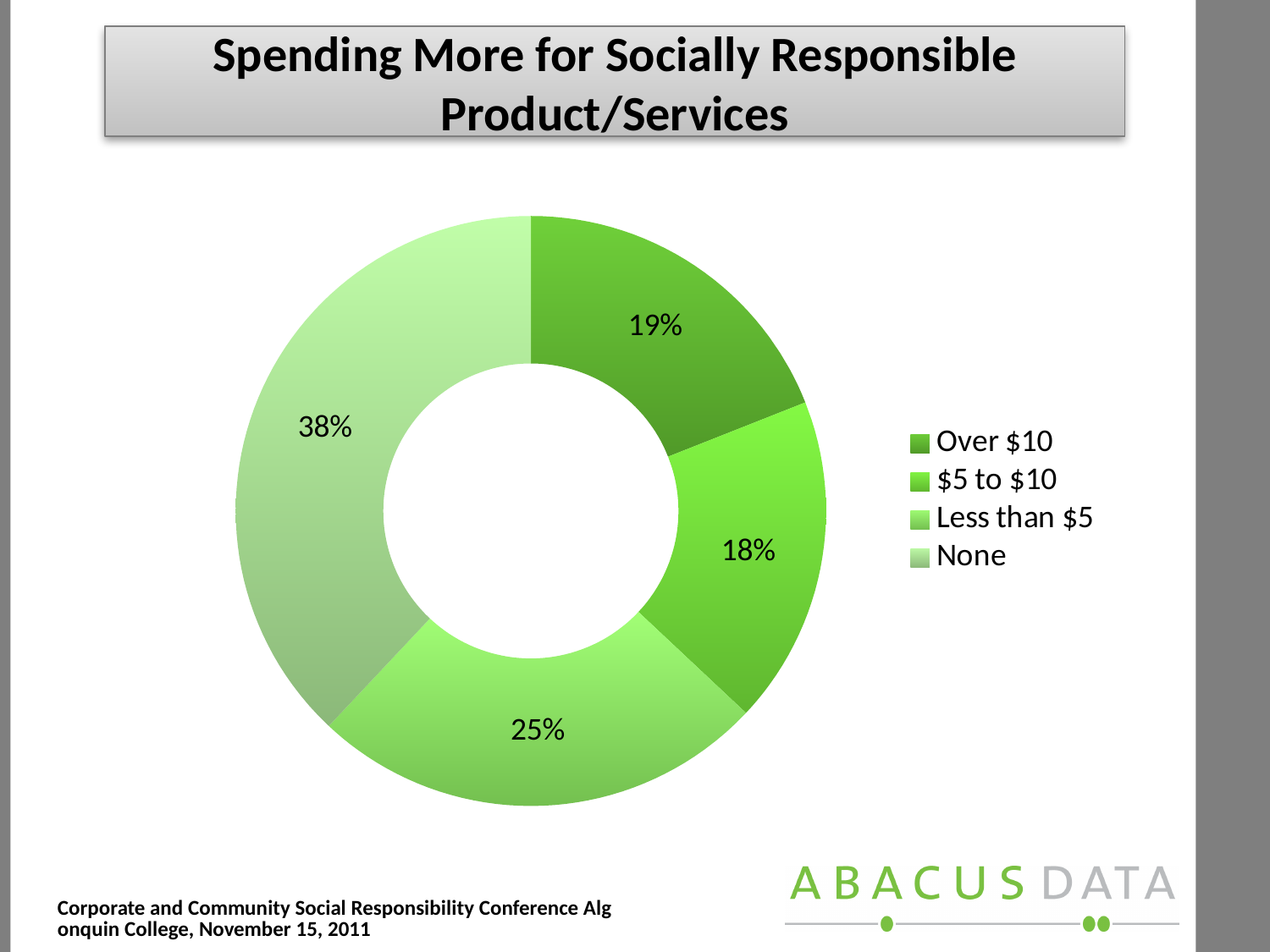
What is the combined share of respondents willing to spend any amount more (Over $10, $5 to $10, and Less than $5)? 62% What percentage of respondents would spend $5 to $10 more? 18% How many categories does the legend list? 4 Which category has the largest share of the chart? None What percentage of respondents would spend none? 38% What percentage of respondents would spend less than $5 more? 25% What kind of chart is shown on the slide? Doughnut (pie) chart Which is larger: the share for 'Over $10' or the share for 'Less than $5'? Less than $5 What is the difference in percentage points between the 'None' share and the 'Less than $5' share? 13 What is the title of the chart? Spending More for Socially Responsible Product/Services What percentage of respondents would spend over $10 more for socially responsible products/services? 19% Which category has the smallest share of the chart? $5 to $10